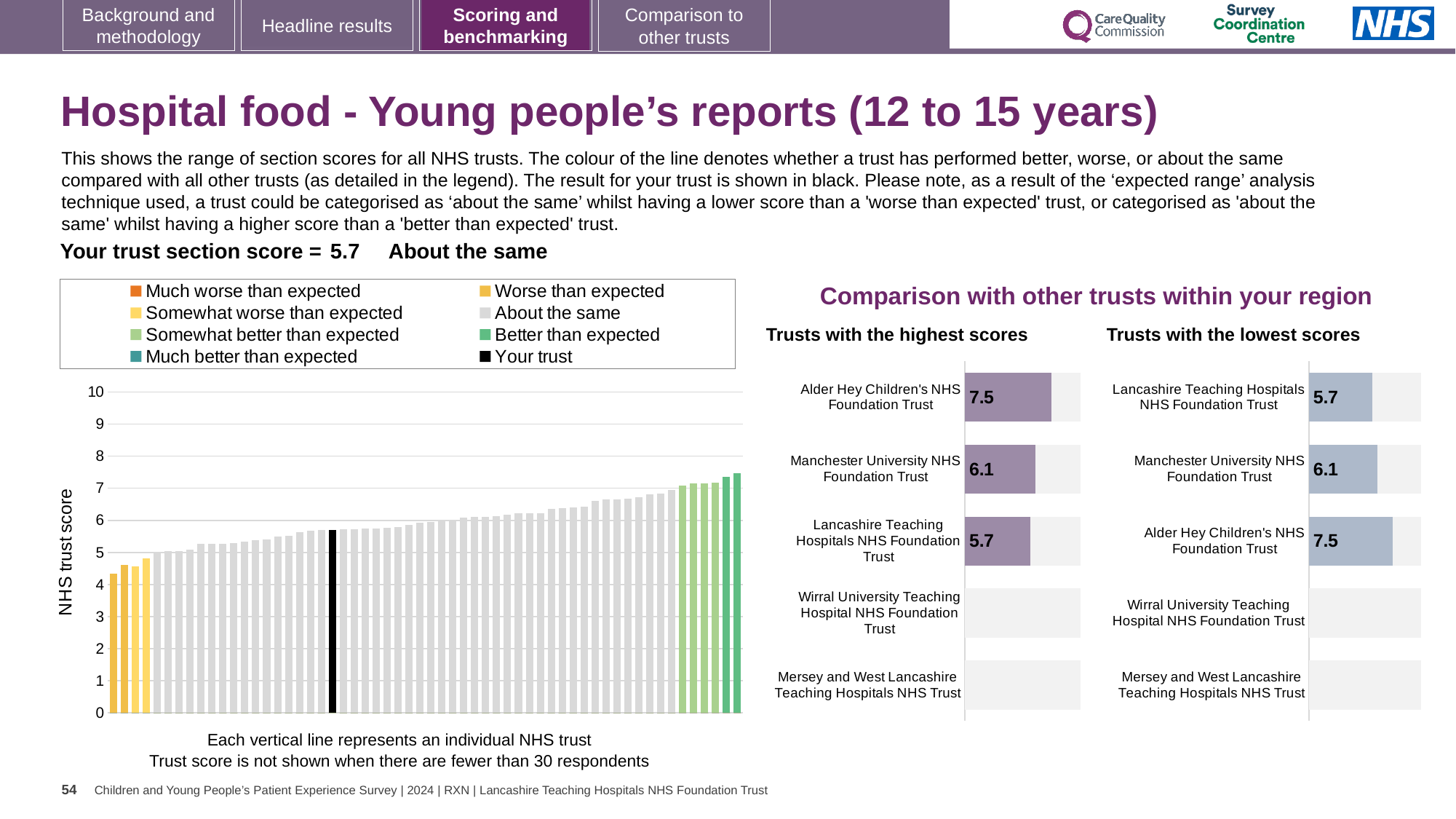
In the 'Trusts with the lowest scores' chart, which has the larger score: Manchester University NHS Foundation Trust or Lancashire Teaching Hospitals NHS Foundation Trust? Manchester University NHS Foundation Trust In the 'Trusts with the highest scores' chart, which trust has the highest score? Alder Hey Children's NHS Foundation Trust In the large chart on the left, do the trust scores rise or fall from left to right? rise What kind of chart is the large chart on the left showing NHS trust scores? bar chart In the 'Trusts with the highest scores' chart, how many trusts are listed? 5 In the 'Trusts with the highest scores' chart, what is the score for Alder Hey Children's NHS Foundation Trust? 7.5 In the 'Trusts with the highest scores' chart, what is the difference between the scores of Alder Hey Children's NHS Foundation Trust and Manchester University NHS Foundation Trust? 1.4 In the 'Trusts with the lowest scores' chart, which trust with a score shown has the lowest score? Lancashire Teaching Hospitals NHS Foundation Trust In the 'Trusts with the lowest scores' chart, what is the score for Lancashire Teaching Hospitals NHS Foundation Trust? 5.7 In the 'Trusts with the highest scores' chart, what is the score for Manchester University NHS Foundation Trust? 6.1 In the large chart on the left, is the value for the black 'Your trust' bar greater or less than 5? greater How many entries does the legend above the large chart on the left list? 8